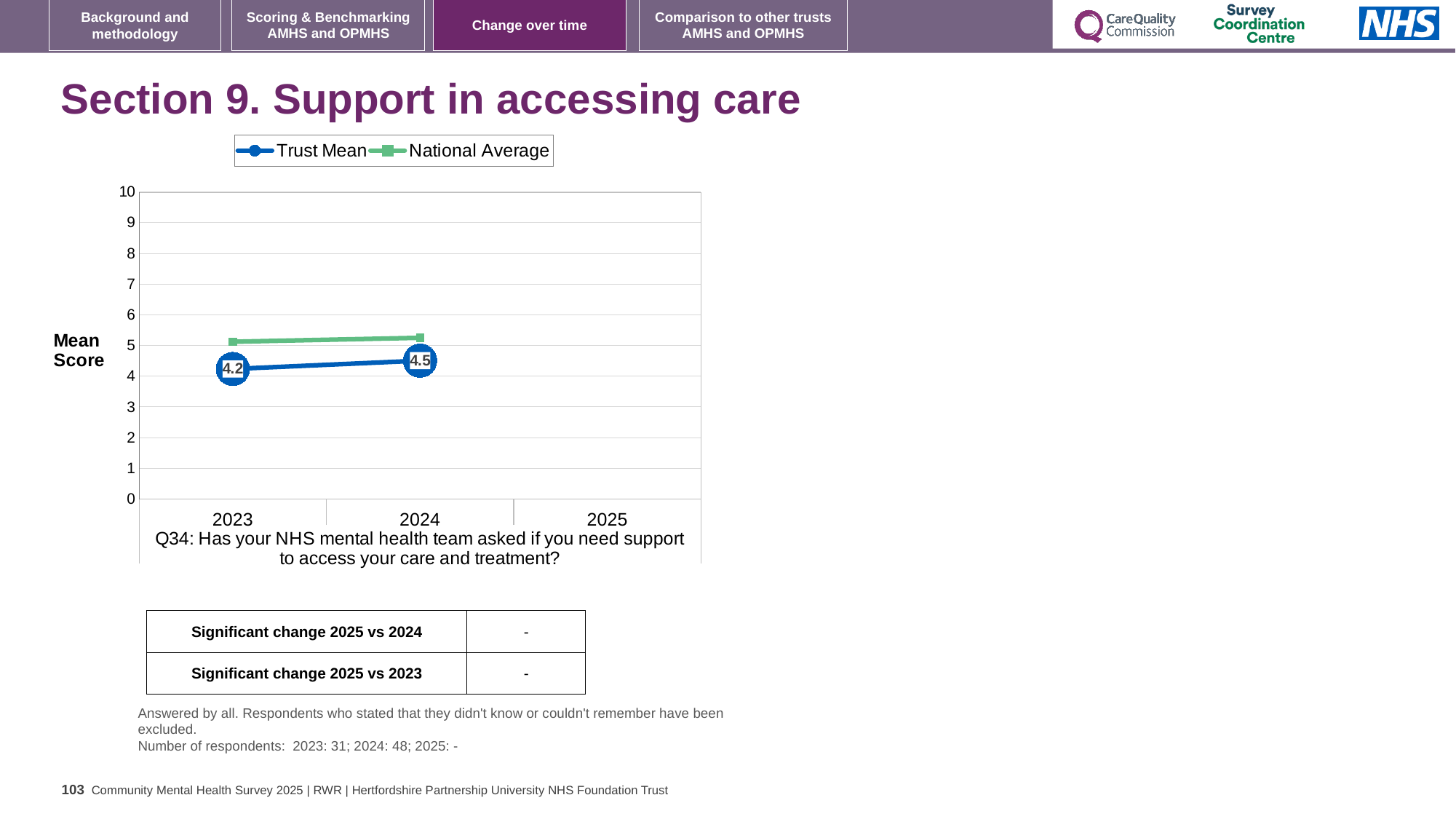
Is the National Average value for 2023 greater or less than 6? less Is the National Average value for 2024 greater or less than 4? greater In 2023, which series has the higher value, Trust Mean or National Average? National Average How many series does the legend list? 2 Which year has the higher Trust Mean score, 2023 or 2024? 2024 Does the Trust Mean score rise or fall from 2023 to 2024? rise What is the label on the y axis of the chart? Mean Score What is the Trust Mean score for 2023? 4.2 By how much did the Trust Mean score change from 2023 to 2024? 0.3 What kind of chart is shown on the slide? line chart What is the Trust Mean score for 2024? 4.5 How many years are shown on the x axis? 3